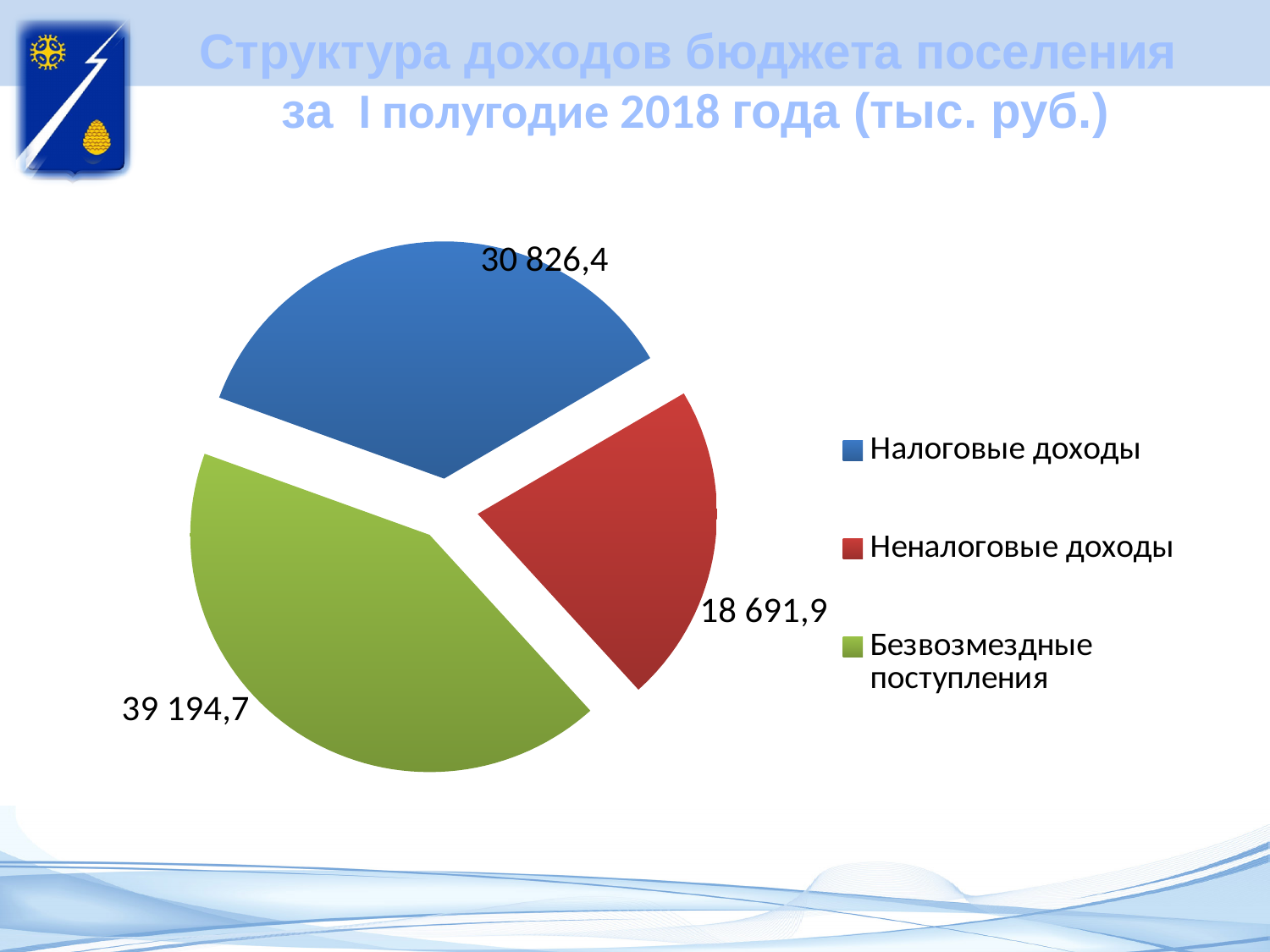
What is the difference between Безвозмездные поступления and Налоговые доходы? 8 368,3 Which category has the largest slice of the pie? Безвозмездные поступления What is the value for Налоговые доходы? 30 826,4 What colour is the slice for Безвозмездные поступления? Green What is the title of the chart on the slide? Структура доходов бюджета поселения за I полугодие 2018 года (тыс. руб.) Which category has the smallest slice of the pie? Неналоговые доходы What is the value for Неналоговые доходы? 18 691,9 What is the difference between Налоговые доходы and Неналоговые доходы? 12 134,5 How many slices does the pie chart have? 3 What is the value for Безвозмездные поступления? 39 194,7 What type of chart is shown on the slide? Pie chart Which is larger, Налоговые доходы or Неналоговые доходы? Налоговые доходы